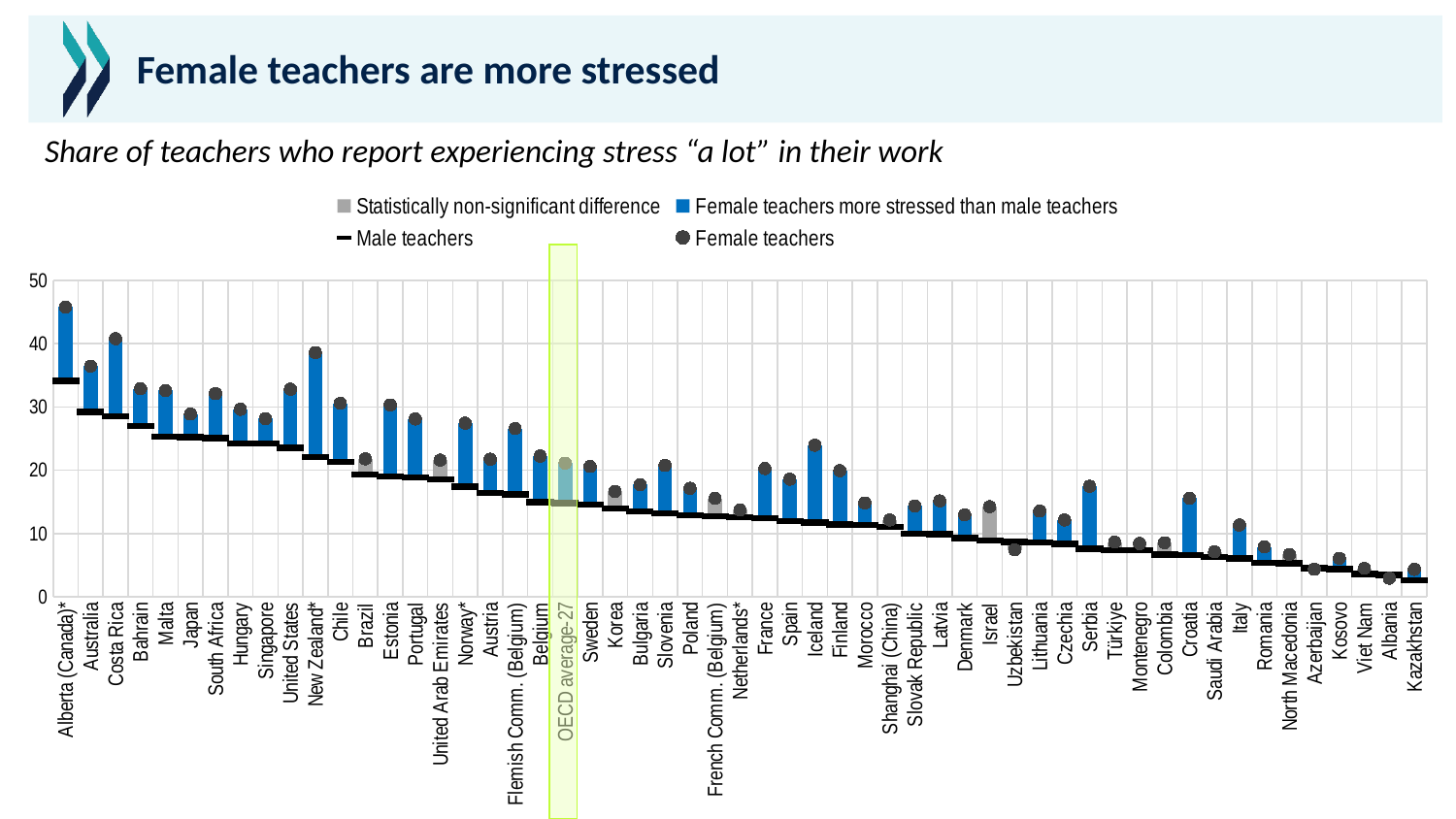
Is the value for female teachers in Kazakhstan greater or less than 10? less How many entries does the legend list? 4 Is the value for female teachers in Alberta (Canada)* greater or less than 40? greater Is the value for female teachers in Iceland greater or less than 20? greater What kind of chart is shown on the slide? bar chart Which is larger, the female teachers value for Costa Rica or for Bahrain? Costa Rica Which category has the highest value for female teachers? Alberta (Canada)* Which category is highlighted with a shaded box on the chart? OECD average-27 Do the female teachers values generally rise or fall from left to right along the x axis? fall Which is larger, the female teachers value for Iceland or for Israel? Iceland